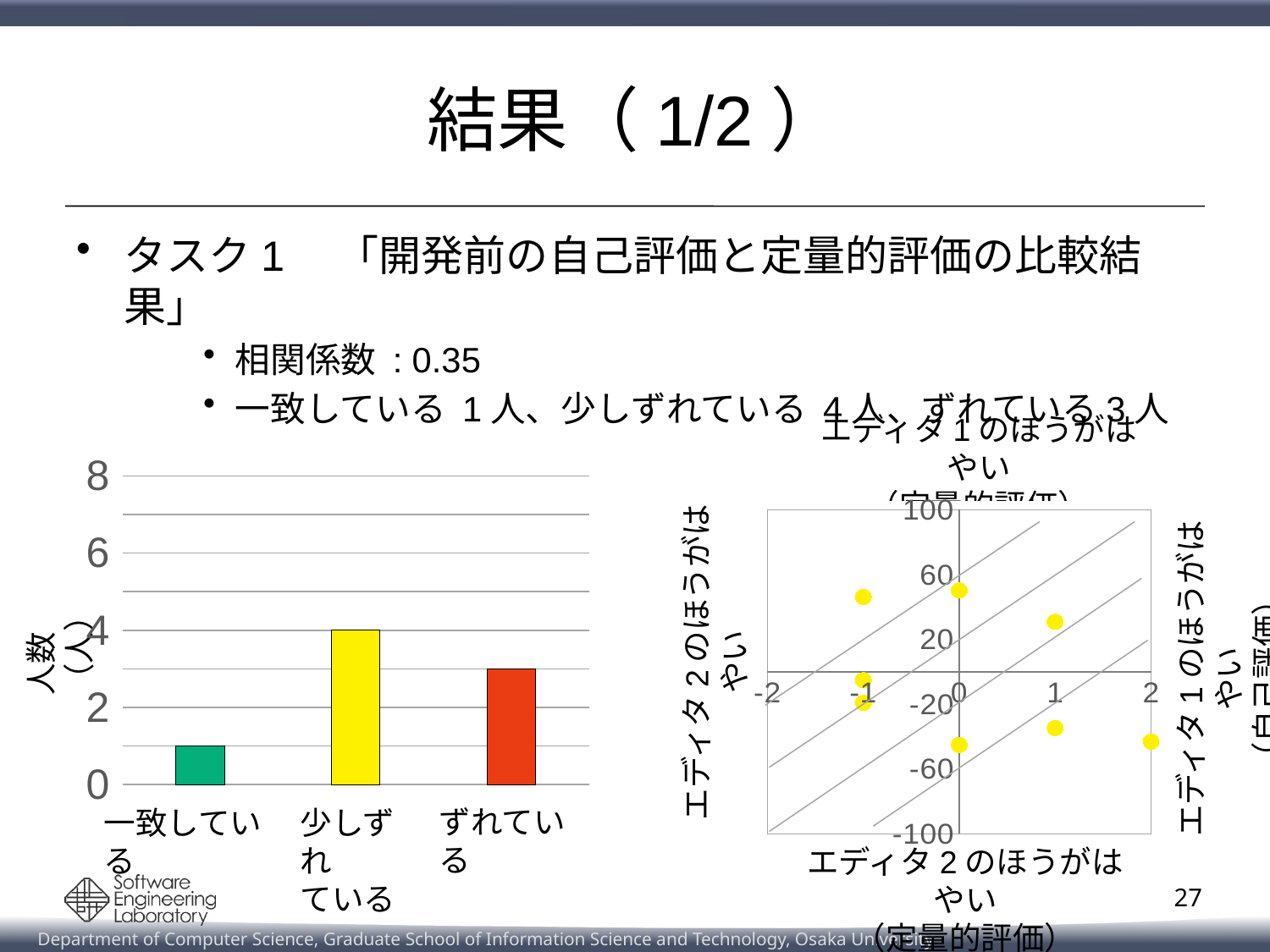
In the left bar chart, which category has the highest value? 少しずれている In the left bar chart, how many people are in the ずれている category? 3 In the left bar chart, which is larger, ずれている or 一致している? ずれている In the left bar chart, what is the difference between 少しずれている and ずれている? 1 In the left bar chart, which category has the lowest value? 一致している In the left bar chart, how many people are in the 少しずれている category? 4 How many categories does the left bar chart have? 3 In the left bar chart, how many people are in the 一致している category? 1 In the left bar chart, what colour is the bar for 少しずれている? yellow What type of chart is the left chart showing 人数(人)? bar chart What type of chart is the right chart with the yellow points? scatter chart How many points are plotted in the right scatter chart? 8